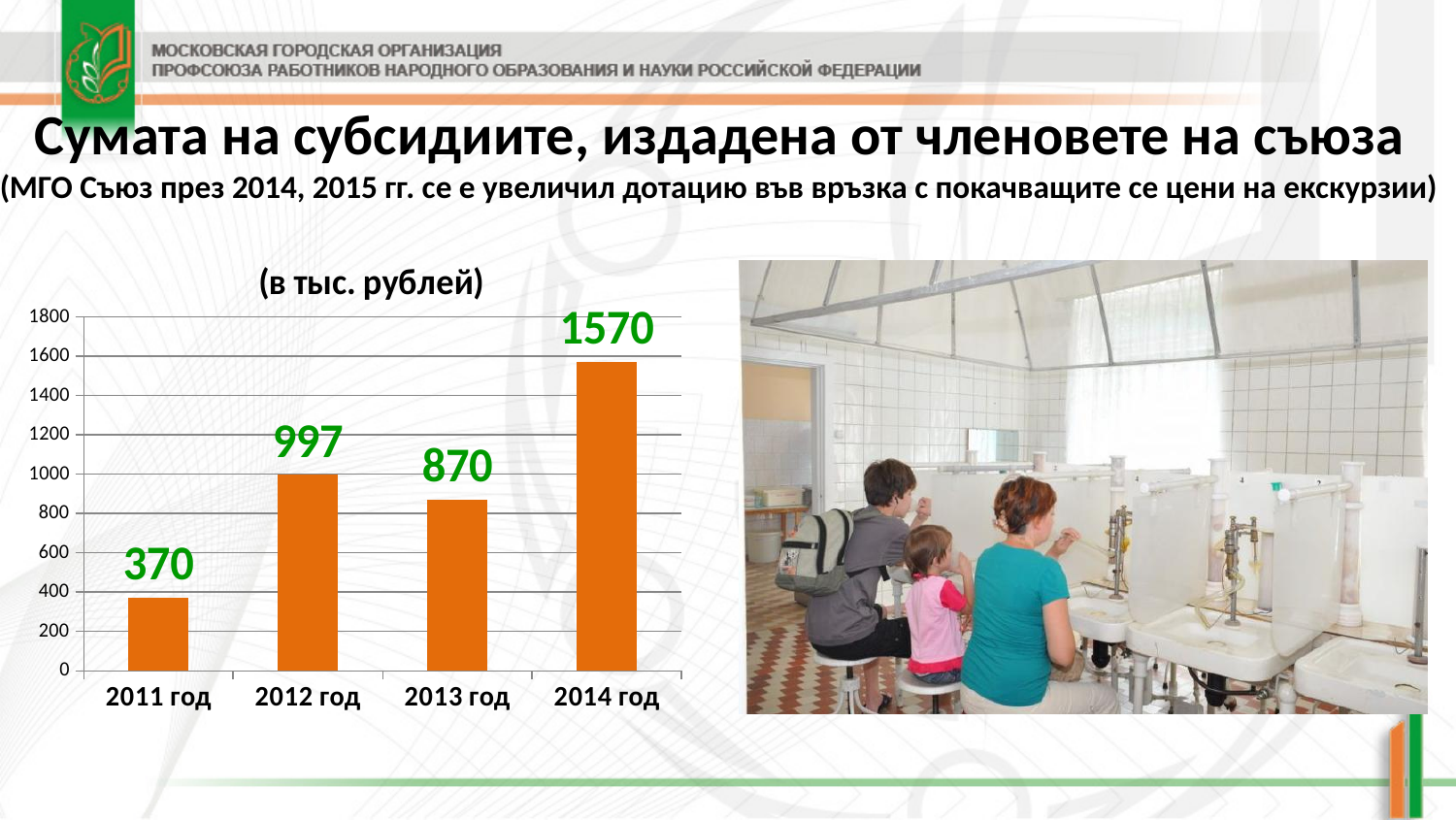
What is the value for 2011 год? 370 Which is larger, the value for 2012 год or 2013 год? 2012 год What is the value for 2014 год? 1570 Which year has the highest value? 2014 год What kind of chart is shown on the slide? bar chart What unit is given in the chart title? в тыс. рублей How many years are shown on the chart? 4 What is the value for 2013 год? 870 What is the value for 2012 год? 997 Is the value for 2014 год greater or less than 1400? greater What is the difference between the values for 2014 год and 2013 год? 700 Which year has the lowest value? 2011 год